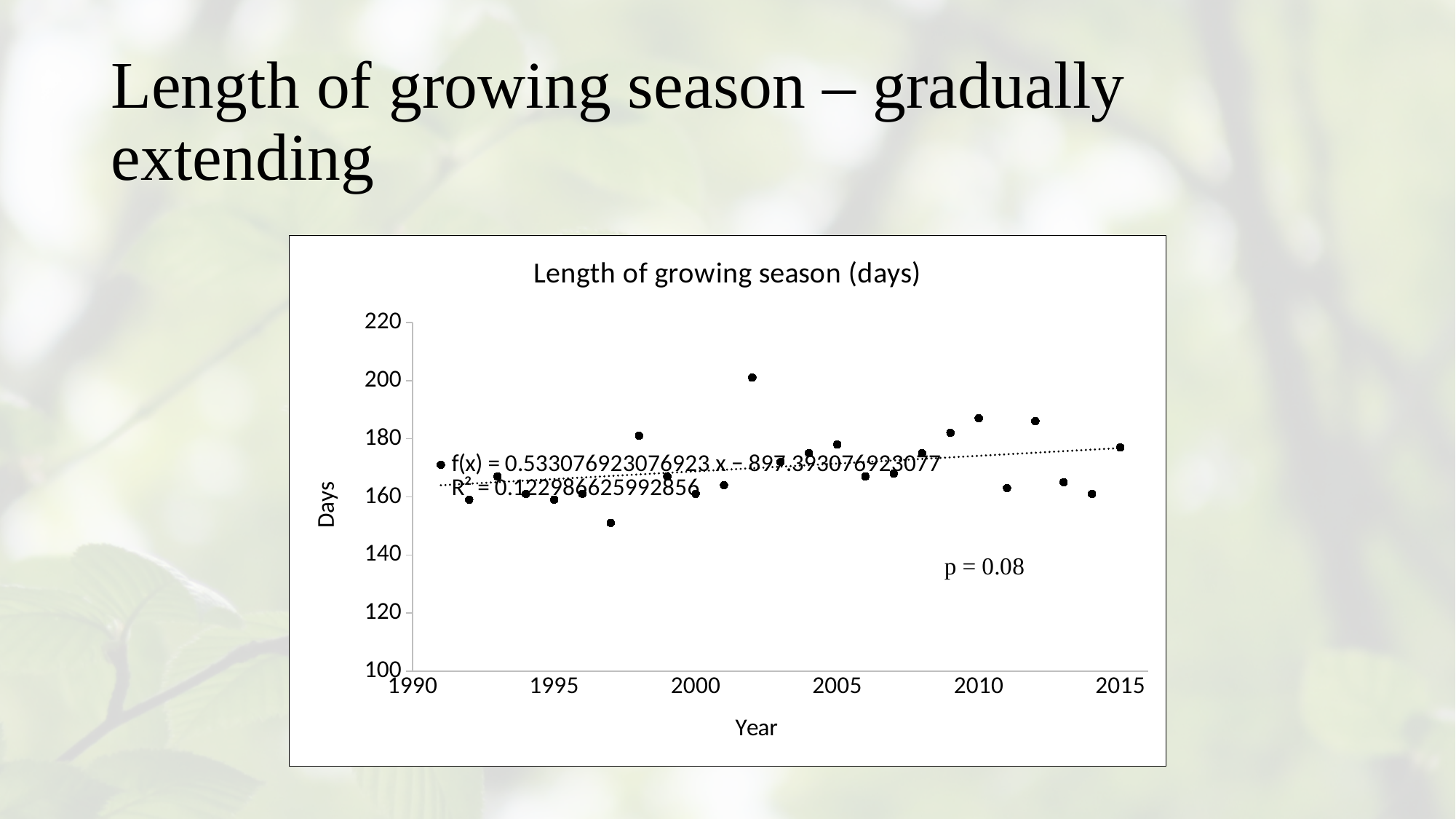
Is the value for 1997 greater or less than 160? less According to the fitted trendline, does the length of the growing season rise or fall over the years? rise Which year has the larger value, 2012 or 2011? 2012 What is the title of the chart? Length of growing season (days) In which year is the length of the growing season highest? 2002 What kind of chart is shown on the slide? scatter chart Is the value for 2002 greater or less than 180? greater Is the value for 2014 greater or less than 180? less Which year has the larger value, 1998 or 1997? 1998 In which year is the length of the growing season lowest? 1997 What is the label of the vertical axis? Days